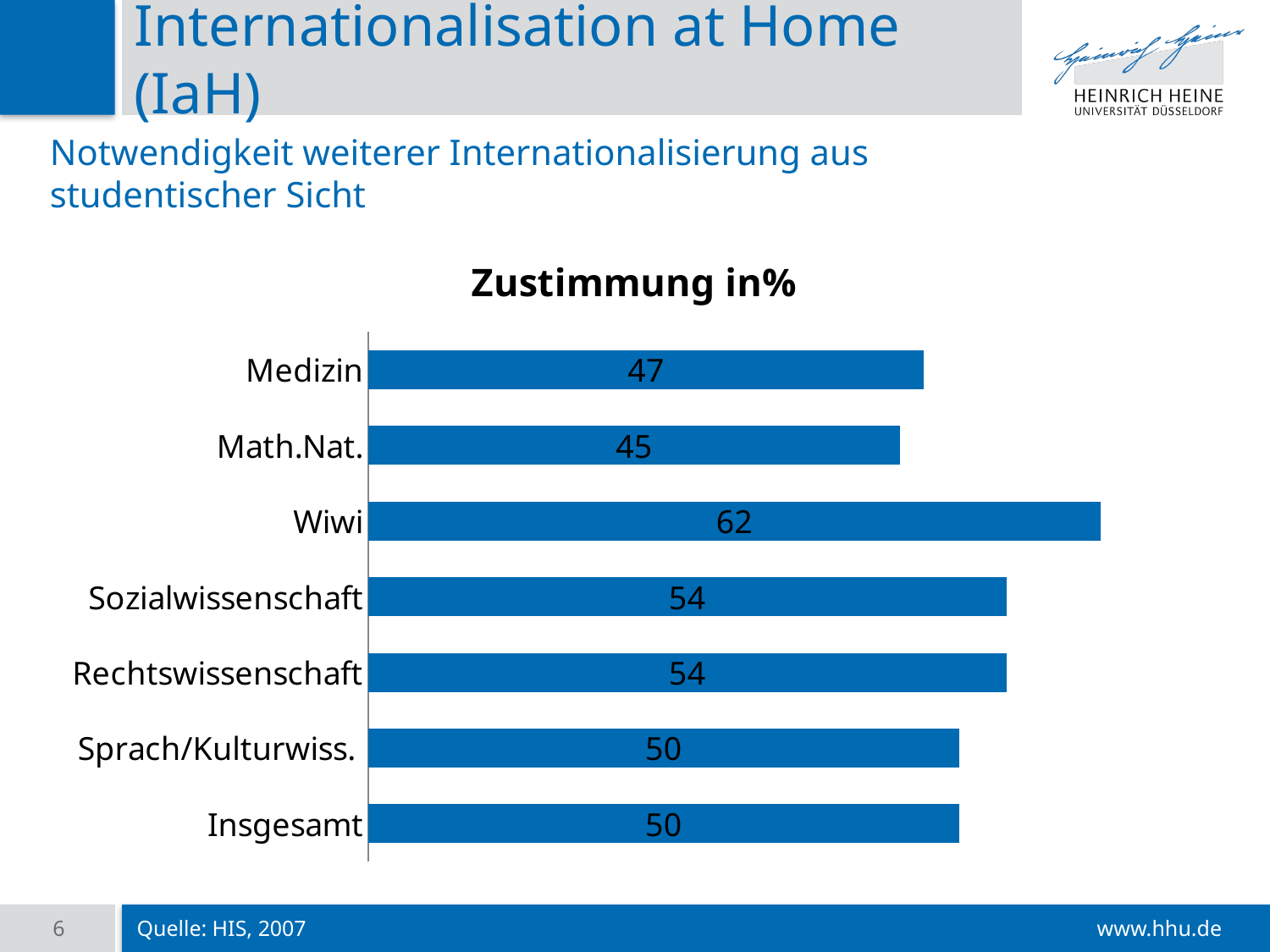
Which is larger, the value for Rechtswissenschaft or the value for Sprach/Kulturwiss.? Rechtswissenschaft Which category has the lowest value? Math.Nat. What is the title of the chart? Zustimmung in% Which category has the highest value? Wiwi What kind of chart is shown on the slide? bar chart What is the value for Insgesamt? 50 What is the difference between the values for Sozialwissenschaft and Medizin? 7 What is the difference between the values for Wiwi and Math.Nat.? 17 How many categories are shown in the chart? 7 What is the value for Sozialwissenschaft? 54 What is the value for Medizin? 47 What is the value for Wiwi? 62